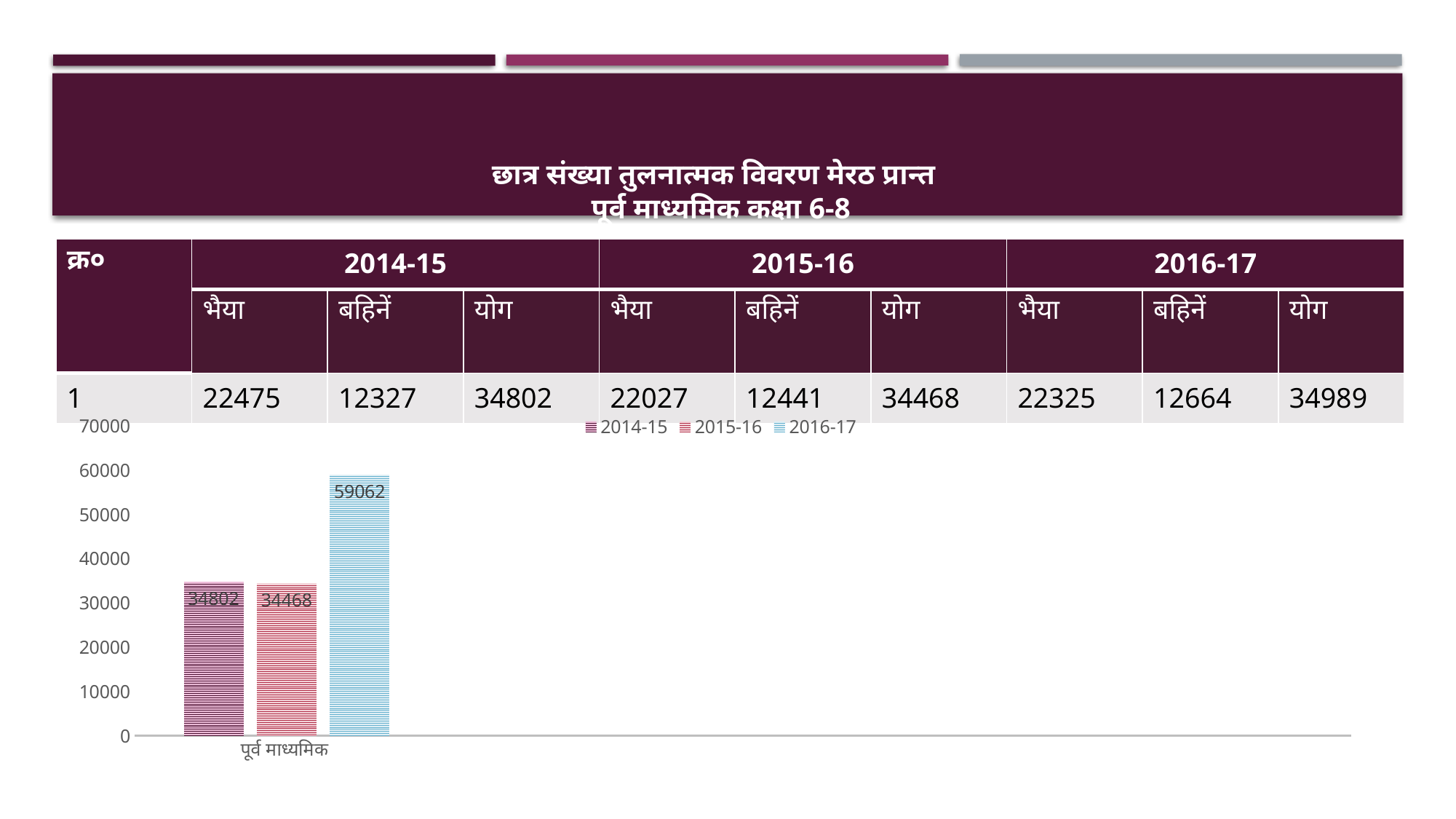
What is the difference between the 2016-17 bar and the 2014-15 bar in the chart? 24260 How many series does the chart legend list? 3 Which series has the highest bar in the chart? 2016-17 What is the category label shown on the x axis of the chart? पूर्व माध्यमिक What is the difference between the 2014-15 bar and the 2015-16 bar in the chart? 334 What is the value of the 2015-16 bar in the chart? 34468 Is the value of the 2016-17 bar greater or less than 50000? greater What type of chart is shown on the slide? bar chart What is the value of the 2014-15 bar in the chart? 34802 What is the value of the 2016-17 bar in the chart? 59062 Which series has the lowest bar in the chart? 2015-16 How many categories are shown on the x axis of the chart? 1